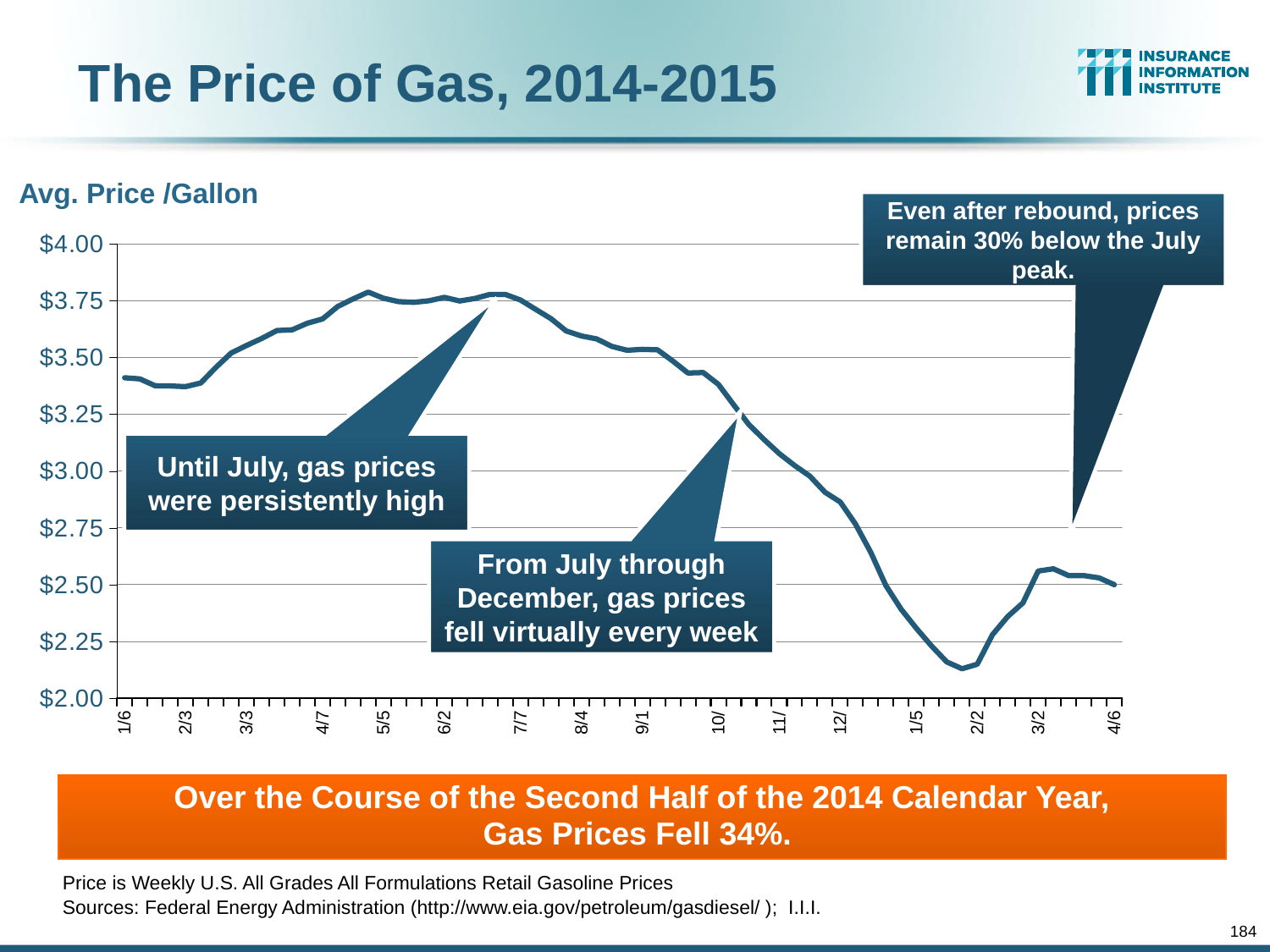
Is the value at 9/1 greater or less than $3.25? greater Is the value at 7/7 greater or less than $3.50? greater What kind of chart is shown on the slide? line chart Do gas prices rise or fall between 2/2 and 3/2? rise Is the value at 4/6 greater or less than $2.25? greater Do gas prices rise or fall between 1/6 and 5/5? rise What label is given to the vertical axis of the chart? Avg. Price /Gallon Do gas prices rise or fall between 7/7 and 12/? fall What is the title of the chart on the slide? The Price of Gas, 2014-2015